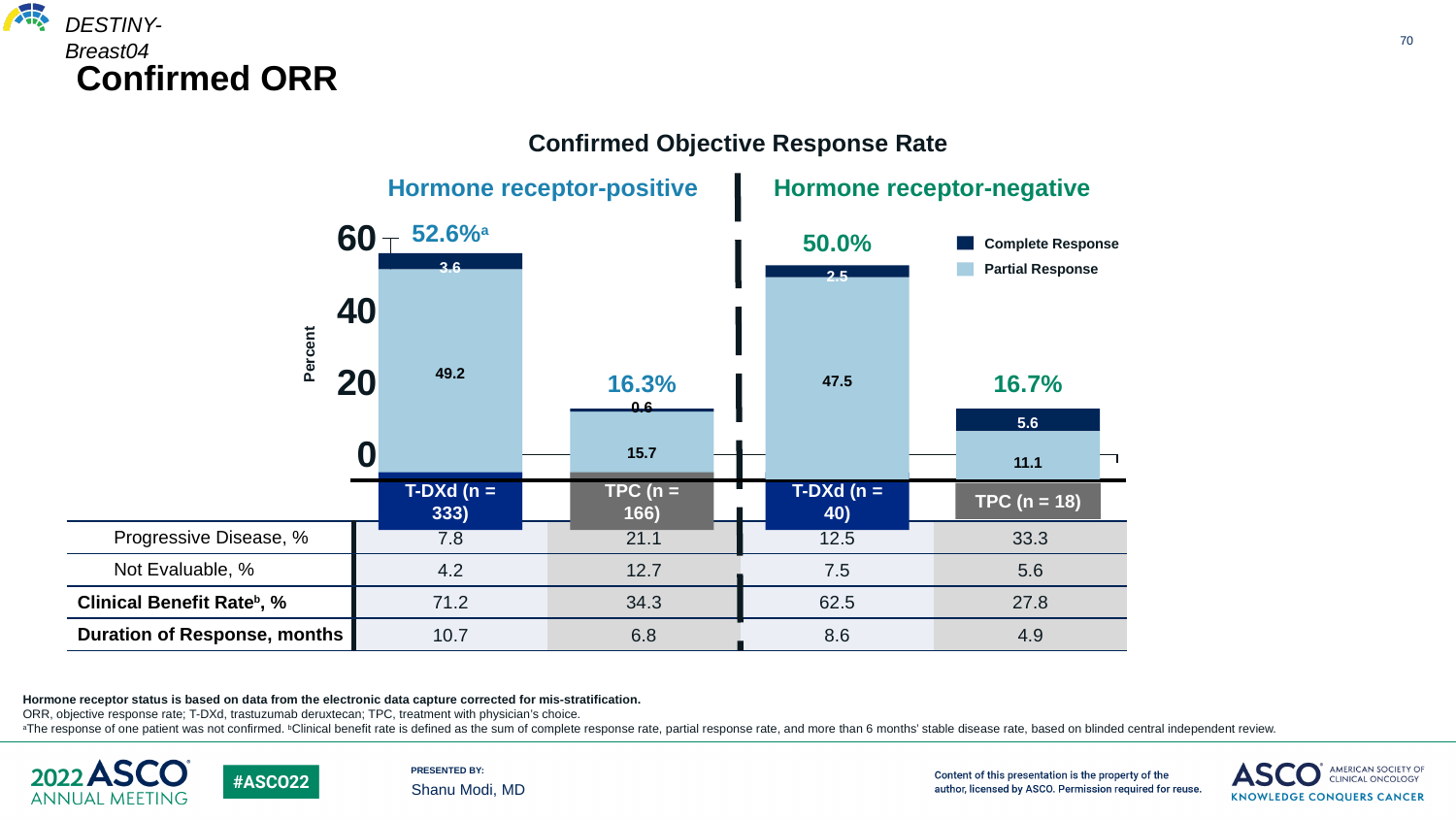
What type of chart is shown on the slide? stacked bar chart What is the confirmed objective response rate for TPC (n = 166) in the hormone receptor-positive group? 16.3% How many series does the legend list? 2 Which bar has the lowest Partial Response value? TPC (n = 18) Which bar has the highest confirmed objective response rate? T-DXd (n = 333) What is the Complete Response value for TPC (n = 18) in the hormone receptor-negative group? 5.6 What is the Partial Response value for T-DXd (n = 333) in the hormone receptor-positive group? 49.2 What is the confirmed objective response rate for T-DXd (n = 40) in the hormone receptor-negative group? 50.0% What is the title of the chart? Confirmed Objective Response Rate Which is larger, the Complete Response value for T-DXd (n = 333) or for T-DXd (n = 40)? T-DXd (n = 333) What is the difference between the Partial Response values for T-DXd (n = 333) and TPC (n = 166)? 33.5 How many bars are plotted in the chart? 4